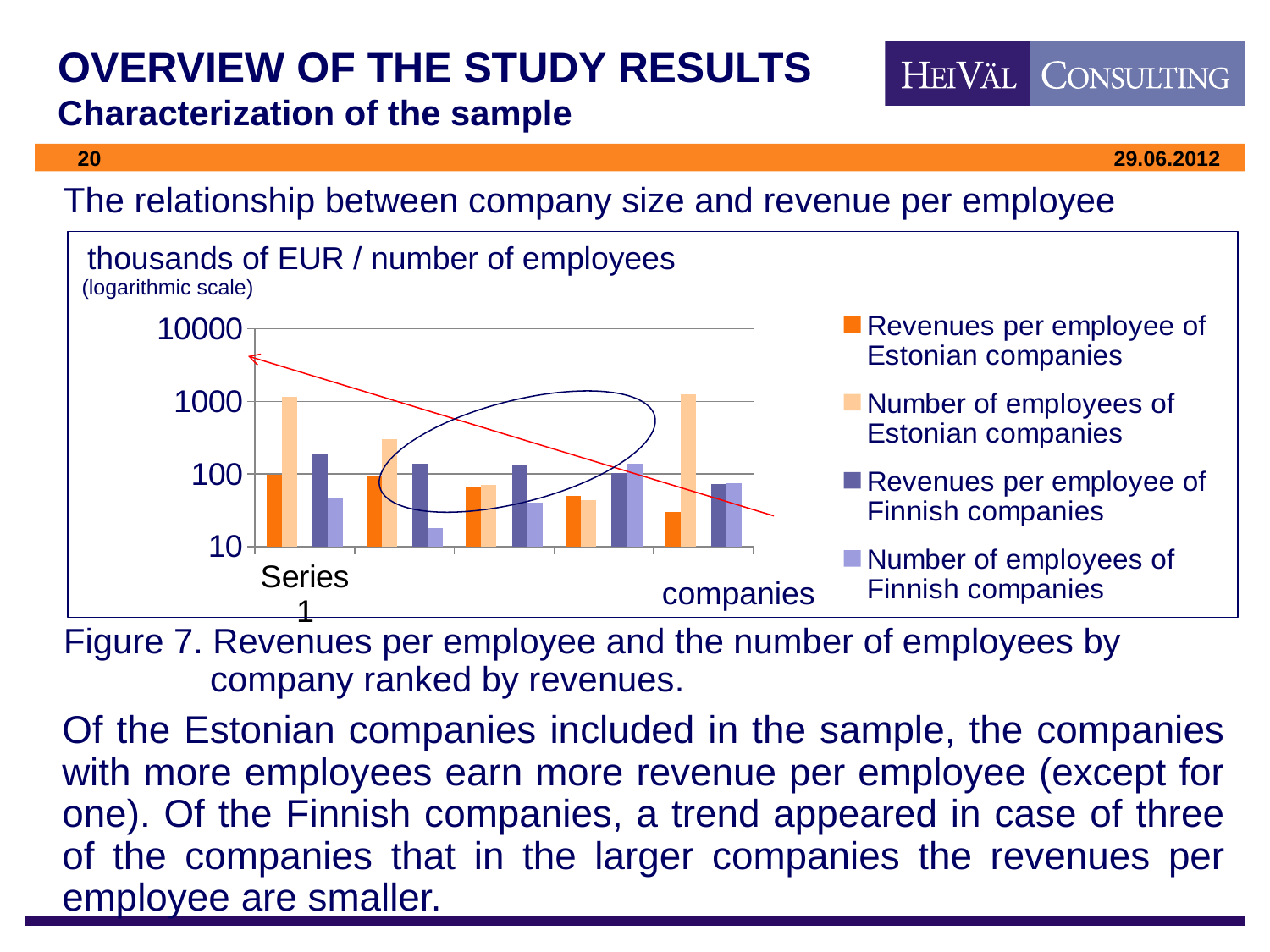
What is the highest value shown on the chart's y axis? 10000 What kind of chart is shown on the slide? bar chart Is the value for Revenues per employee of Finnish companies in Series 1 greater or less than 100? greater Is the value for Number of employees of Estonian companies in Series 1 greater or less than 100? greater How many groups of bars (companies) are plotted along the x axis? 5 In Series 1, which is larger: Revenues per employee of Finnish companies or Number of employees of Finnish companies? Revenues per employee of Finnish companies Do the values for Revenues per employee of Estonian companies rise or fall from left to right along the x axis? fall What kind of scale does the chart's y axis use, according to the note under the axis title? logarithmic scale How many series does the chart's legend list? 4 Which series in Series 1 has the lowest value? Number of employees of Finnish companies In Series 1, which is larger: Number of employees of Estonian companies or Number of employees of Finnish companies? Number of employees of Estonian companies Is the value for Number of employees of Finnish companies in Series 1 greater or less than 100? less